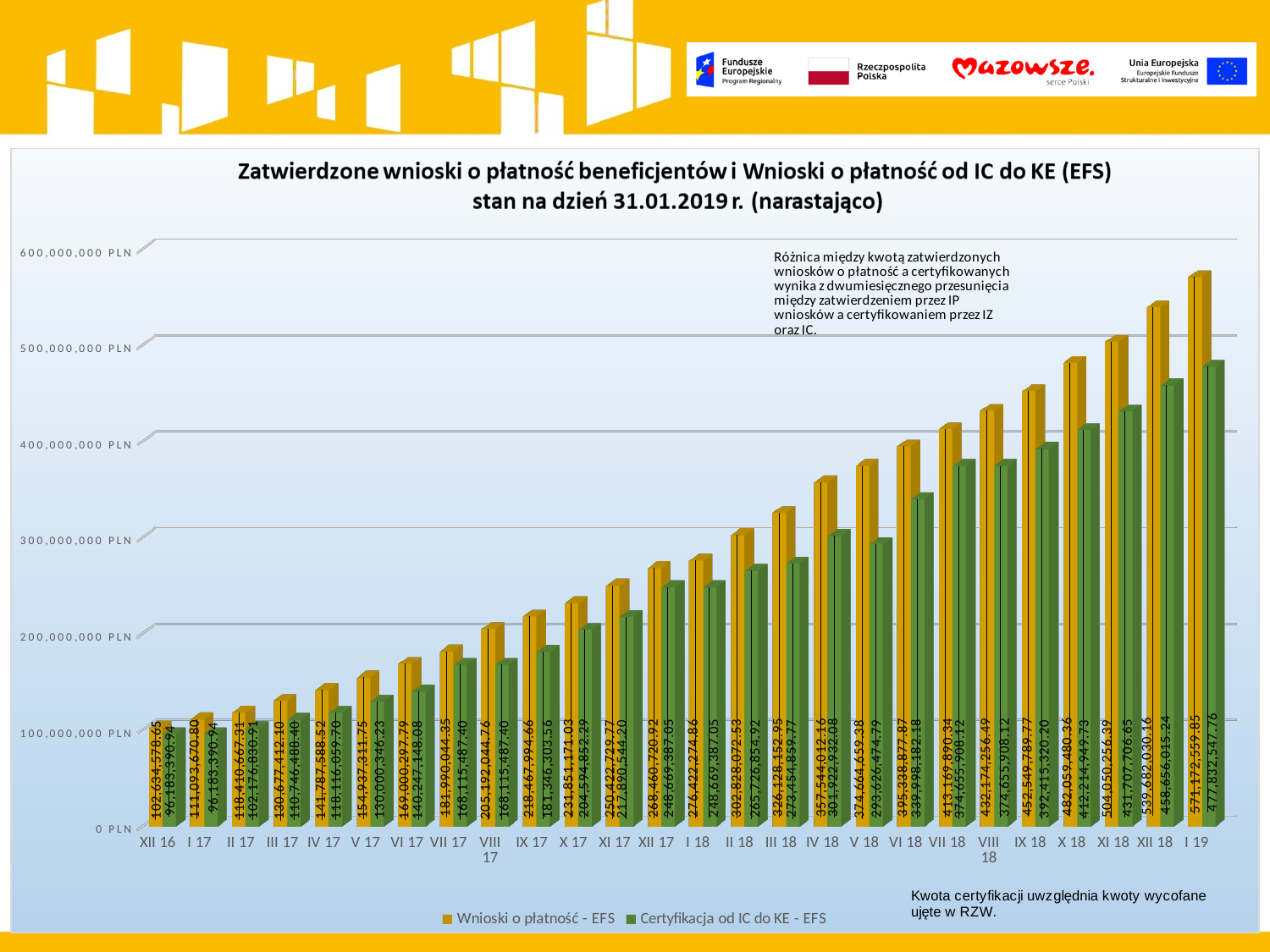
Do the values of 'Wnioski o płatność - EFS' rise or fall from XII 16 to I 19? rise What is the difference between 'Wnioski o płatność - EFS' and 'Certyfikacja od IC do KE - EFS' for I 19? 93,340,012.09 What is the value of 'Wnioski o płatność - EFS' for XII 16? 102,634,578.65 How many time periods (categories) are shown on the x axis? 26 Is the value of 'Certyfikacja od IC do KE - EFS' for XI 18 greater or less than 400,000,000 PLN? greater What kind of chart is shown on the slide? bar chart Which period has the highest value for 'Wnioski o płatność - EFS'? I 19 How many series does the legend list? 2 Which period has the lowest value for 'Wnioski o płatność - EFS'? XII 16 What is the value of 'Certyfikacja od IC do KE - EFS' for I 19? 477,832,547.76 What is the value of 'Wnioski o płatność - EFS' for I 19? 571,172,559.85 What is the value of 'Certyfikacja od IC do KE - EFS' for XII 18? 458,656,015.24